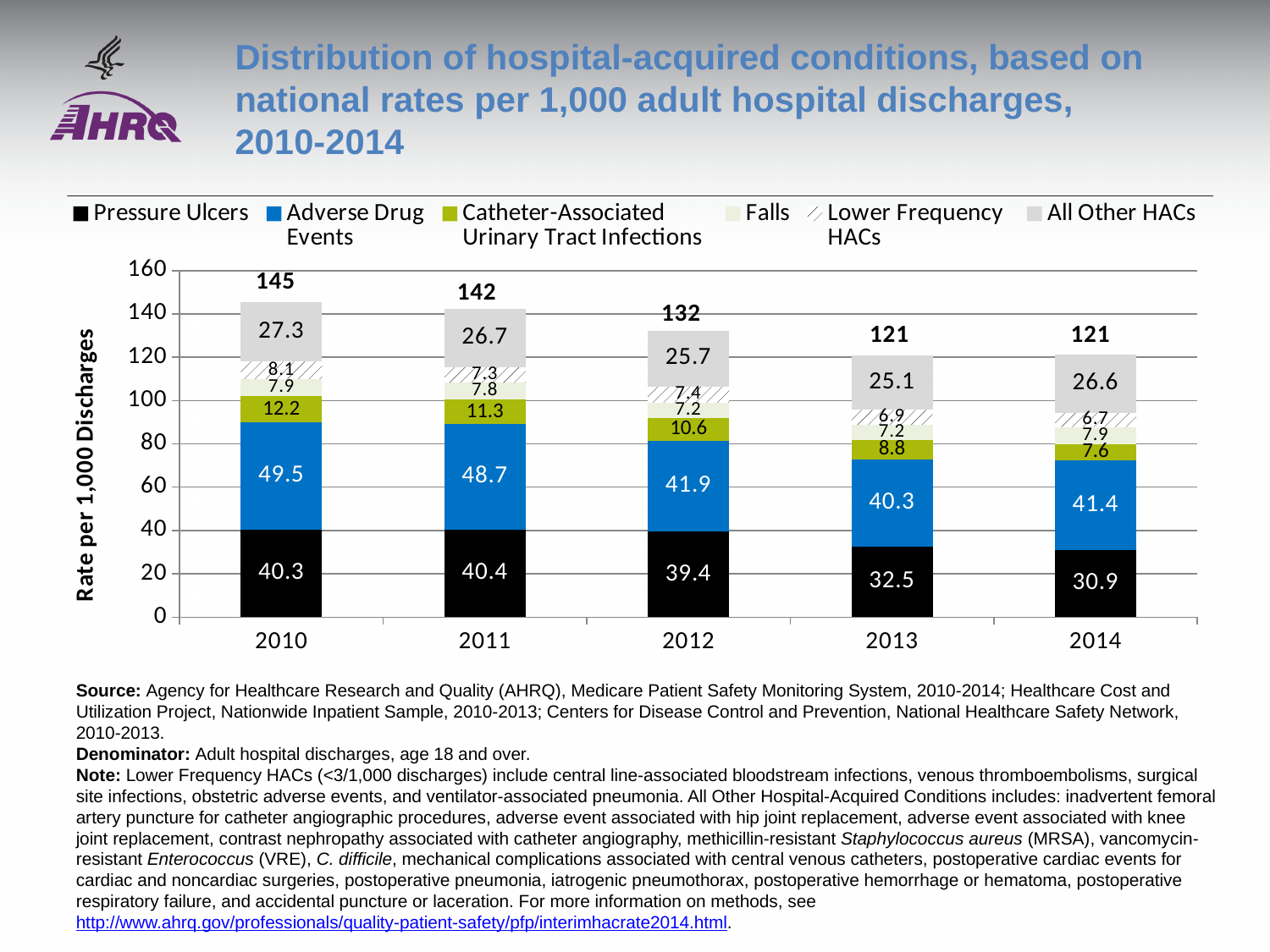
What is the total of the stacked bar for 2010? 145 Which year has the lowest Pressure Ulcers value? 2014 What is the Adverse Drug Events value for 2012? 41.9 What is the Catheter-Associated Urinary Tract Infections value for 2011? 11.3 What kind of chart is shown on the slide? Stacked bar chart Which is larger, the Adverse Drug Events value for 2013 or for 2014? 2014 What is the Pressure Ulcers value for 2014? 30.9 What is the difference between the Pressure Ulcers values for 2010 and 2014? 9.4 How many years are shown on the x axis? 5 Which year has the highest total rate? 2010 What is the All Other HACs value for 2013? 25.1 How many series does the legend list? 6